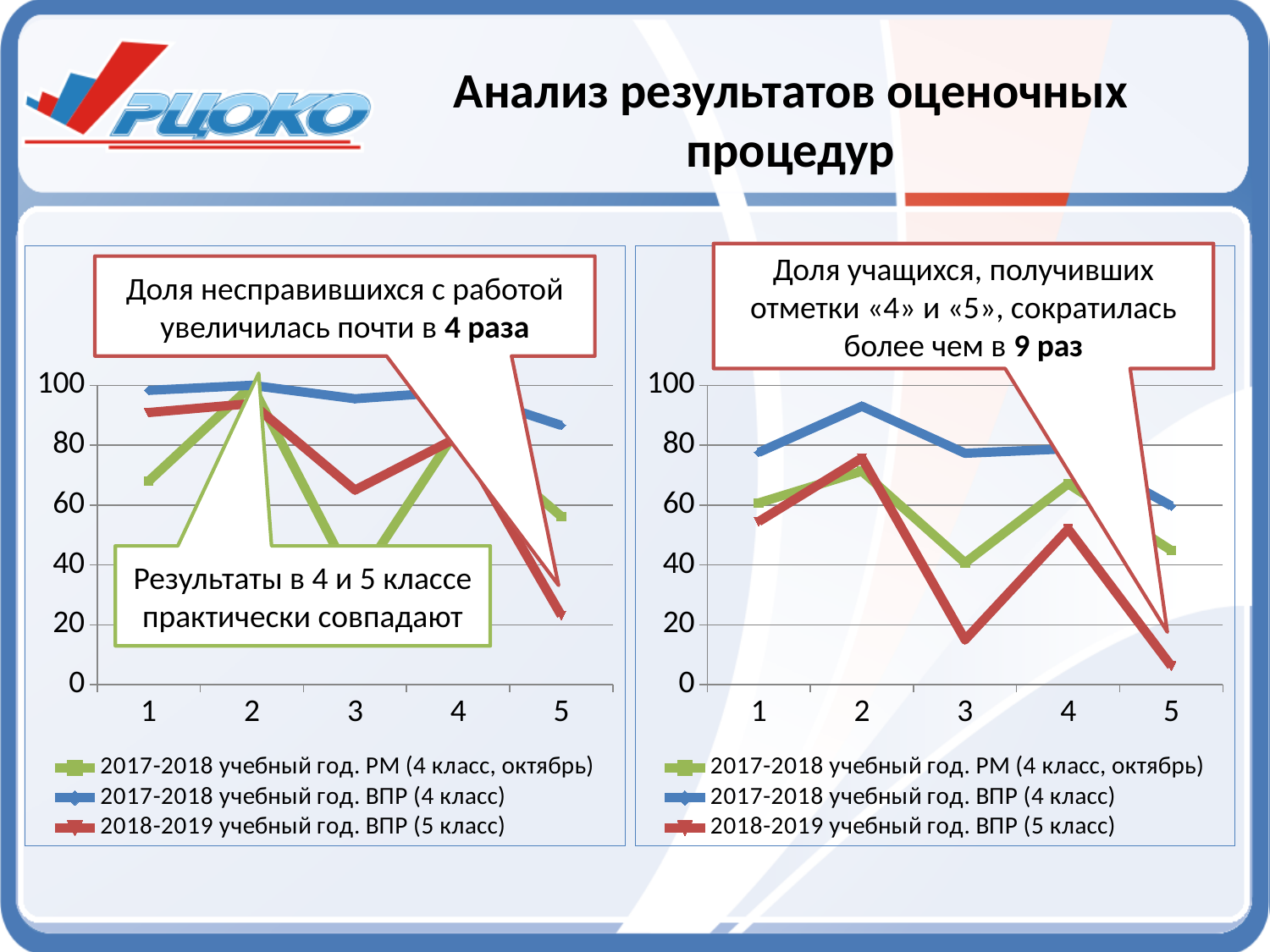
In the right chart, does the 2018-2019 учебный год. ВПР (5 класс) series rise or fall from category 4 to category 5? fall In the right chart, at category 3, which series has the larger value: 2017-2018 учебный год. ВПР (4 класс) or 2018-2019 учебный год. ВПР (5 класс)? 2017-2018 учебный год. ВПР (4 класс) In the right chart, at which category does the 2018-2019 учебный год. ВПР (5 класс) series reach its highest value? 2 In the left chart, is the value of the 2018-2019 учебный год. ВПР (5 класс) series at category 5 greater or less than 40? less How many series does the legend of the right chart list? 3 In the right chart, is the value of the 2017-2018 учебный год. ВПР (4 класс) series at category 2 greater or less than 80? greater How many categories are shown on the x axis of the left chart? 5 In the right chart, is the value of the 2018-2019 учебный год. ВПР (5 класс) series at category 5 greater or less than 20? less What kind of chart is the left chart on the slide? line chart What colour is the line for the 2018-2019 учебный год. ВПР (5 класс) series in the left chart? red In the left chart, at category 5, which series has the larger value: 2017-2018 учебный год. ВПР (4 класс) or 2018-2019 учебный год. ВПР (5 класс)? 2017-2018 учебный год. ВПР (4 класс)